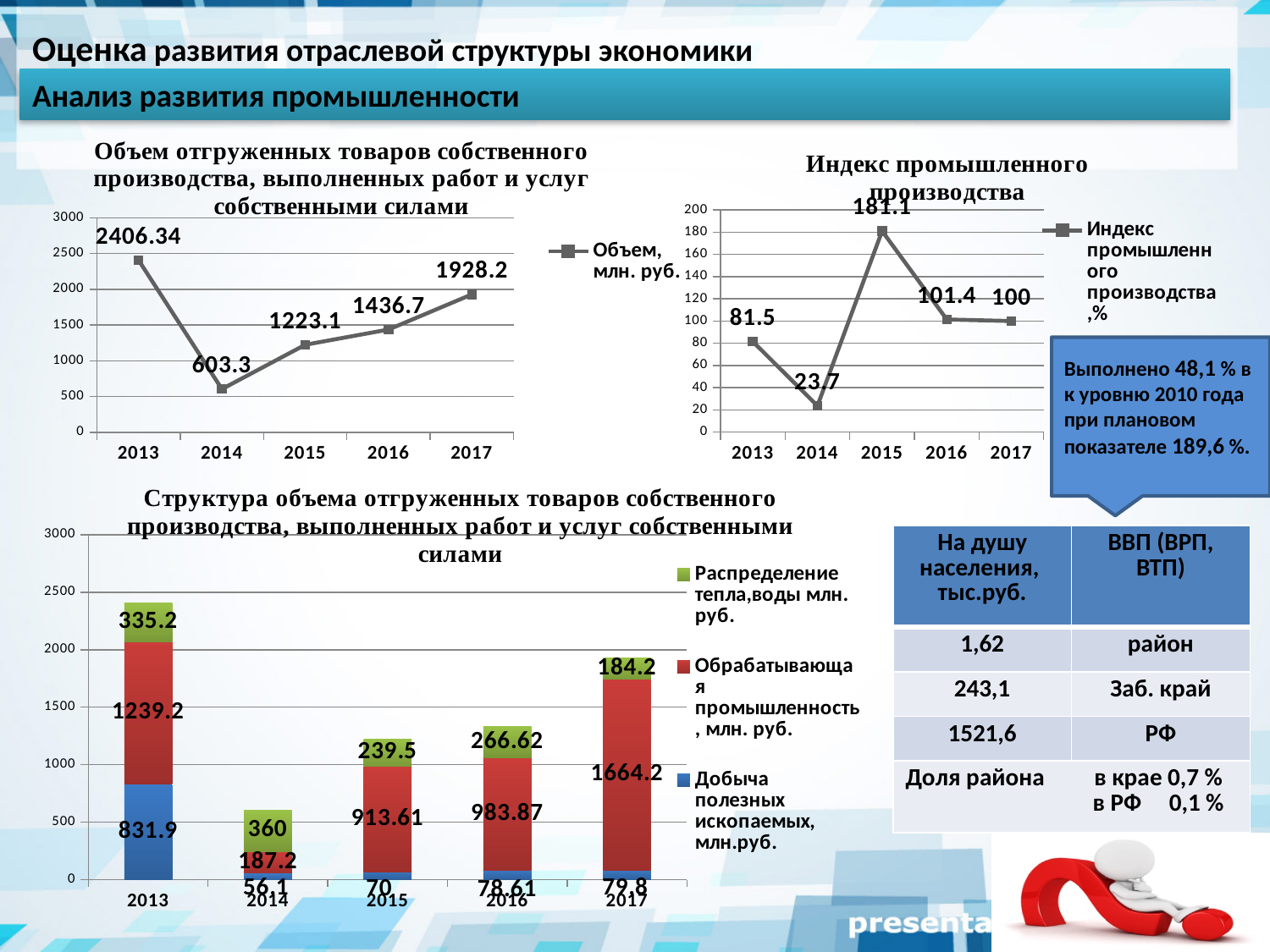
In the bottom chart 'Структура объема отгруженных товаров собственного производства...', which colour represents 'Добыча полезных ископаемых'? blue What kind of chart is 'Индекс промышленного производства'? line chart In the bottom chart 'Структура объема отгруженных товаров собственного производства...', what is the total of the stacked bar for 2014? 603.3 In the chart 'Индекс промышленного производства', what is the value for 2015? 181.1 In the chart 'Индекс промышленного производства', which year has the lowest value? 2014 In the chart 'Объем отгруженных товаров собственного производства, выполненных работ и услуг собственными силами', what is the value for 2013? 2406.34 In the bottom chart 'Структура объема отгруженных товаров собственного производства...', what is the value of 'Обрабатывающая промышленность' for 2017? 1664.2 In the chart 'Индекс промышленного производства', which is larger: the value for 2013 or the value for 2016? 2016 How many series does the legend of the bottom chart 'Структура объема отгруженных товаров собственного производства...' list? 3 In the chart 'Объем отгруженных товаров собственного производства, выполненных работ и услуг собственными силами', which year has the lowest value? 2014 In the chart 'Объем отгруженных товаров собственного производства, выполненных работ и услуг собственными силами', what is the difference between the 2017 and 2016 values? 491.5 In the chart 'Объем отгруженных товаров собственного производства, выполненных работ и услуг собственными силами', do the values rise or fall from 2014 to 2017? rise